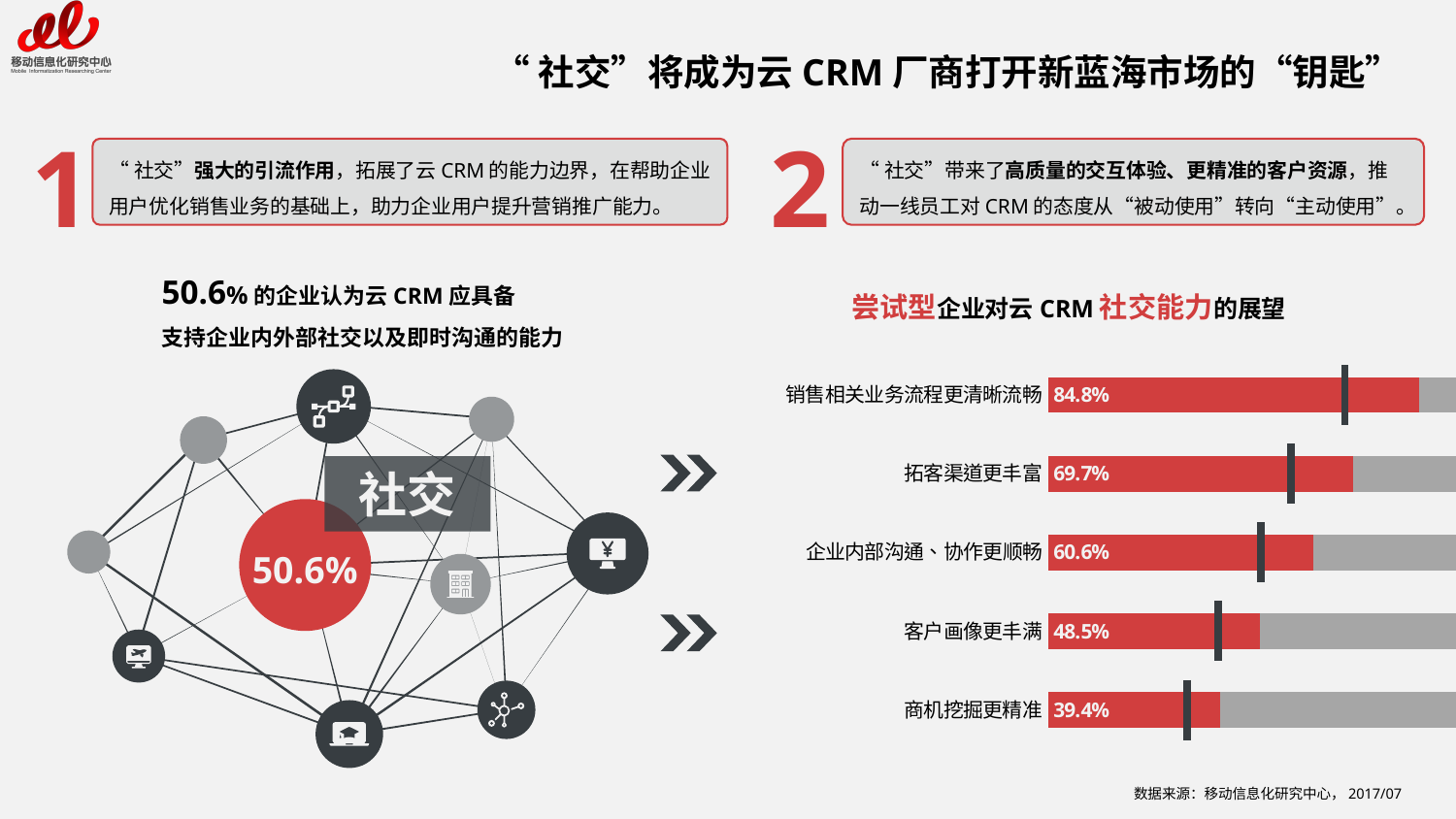
What is the title of the chart on the right side of the slide? 尝试型企业对云 CRM 社交能力的展望 In the bar chart on the right, which is larger: the value for 拓客渠道更丰富 or the value for 客户画像更丰满? 拓客渠道更丰富 In the bar chart on the right, what is the value for 企业内部沟通、协作更顺畅? 60.6% In the bar chart on the right, what is the value for 拓客渠道更丰富? 69.7% In the bar chart titled "尝试型企业对云 CRM 社交能力的展望", what is the value for 销售相关业务流程更清晰流畅? 84.8% In the bar chart on the right, which category has the highest value? 销售相关业务流程更清晰流畅 In the bar chart on the right, what is the value for 商机挖掘更精准? 39.4% In the bar chart on the right, what is the difference between the values for 销售相关业务流程更清晰流畅 and 商机挖掘更精准? 45.4% In the bar chart on the right, which category has the lowest value? 商机挖掘更精准 In the bar chart on the right, what is the value for 客户画像更丰满? 48.5% What kind of chart is shown on the right side of the slide? Bar chart How many categories are shown in the bar chart on the right? 5